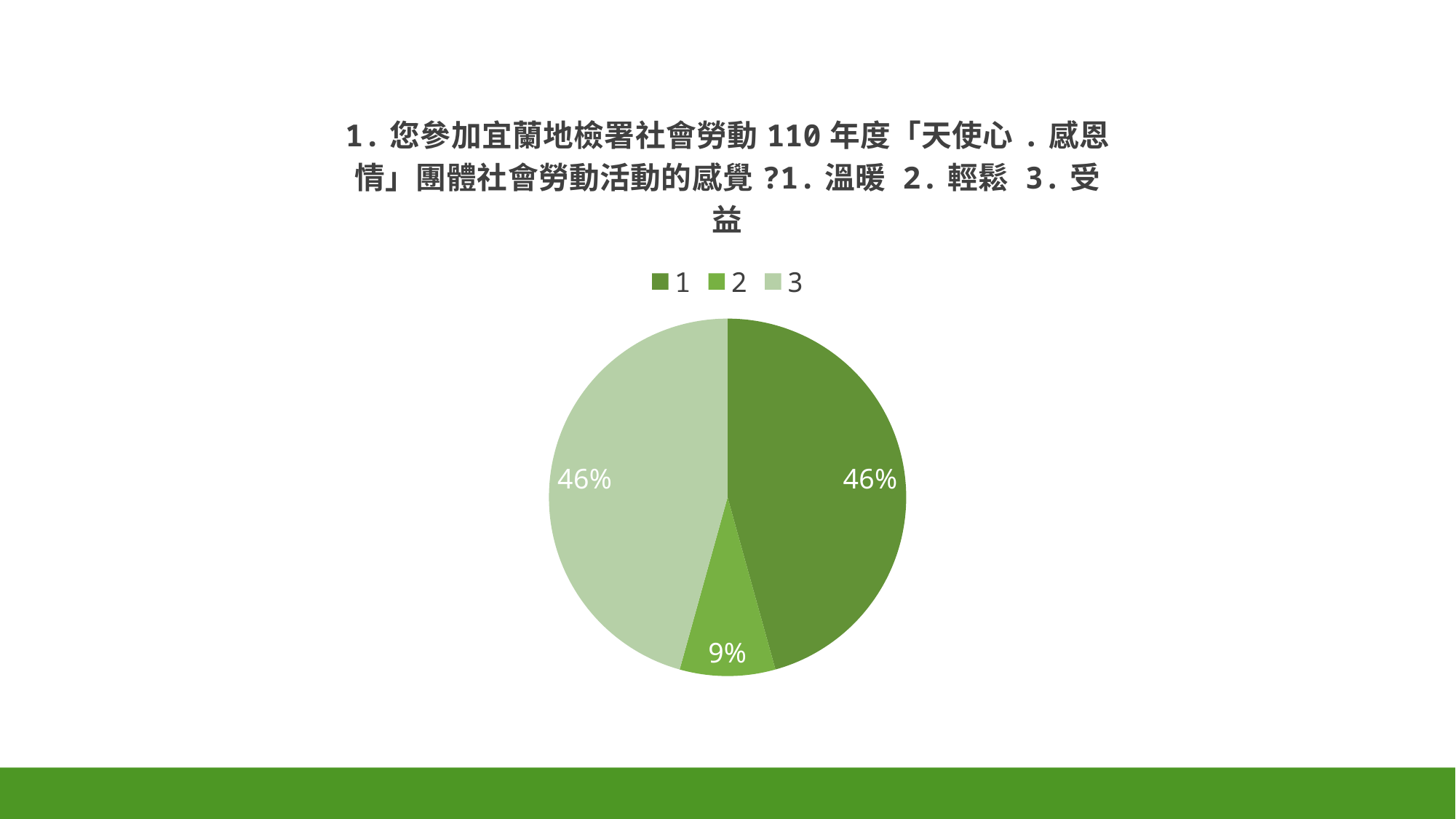
How many entries does the legend list? 3 What share of the pie is taken by category 2? 9% What kind of chart is shown on the slide? pie chart How many slices does the pie chart have? 3 Which is larger, the slice for category 2 or the slice for category 3? 3 What percentage of the pie does category 1 represent? 46% What percentage of the pie does category 3 represent? 46% Which is larger, the slice for category 1 or the slice for category 2? 1 What percentage of the pie does category 2 represent? 9% What is the difference in percentage points between the slice for category 3 and the slice for category 2? 37 Which category has the smallest slice of the pie? 2 Which legend entry is shown in the lightest green colour? 3